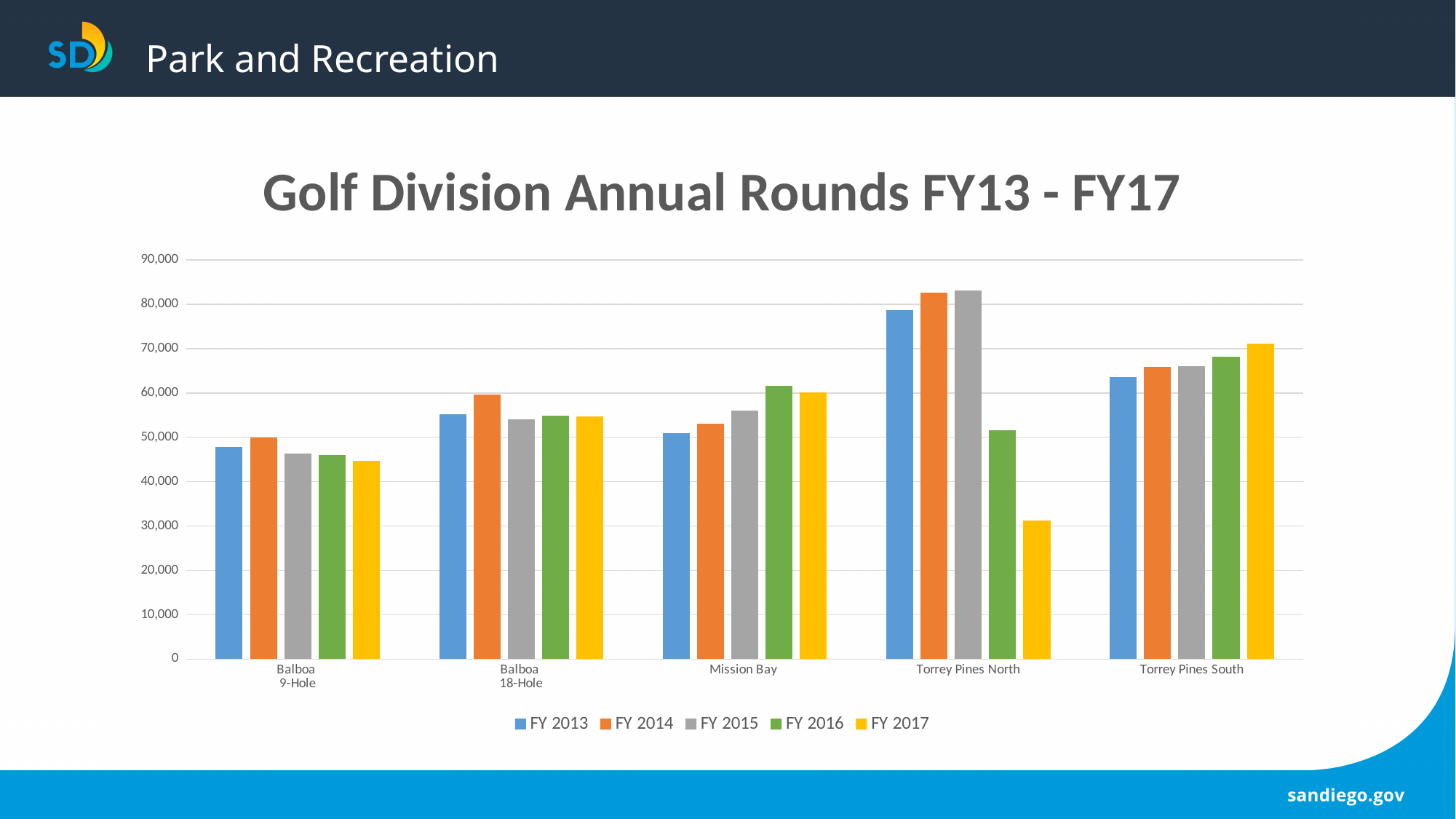
What is the title of the chart? Golf Division Annual Rounds FY13 - FY17 What kind of chart is shown on the slide? Bar chart How many golf course categories are shown on the x axis? 5 Which is larger for FY 2014: Balboa 9-Hole or Balboa 18-Hole? Balboa 18-Hole Is the FY 2017 value for Torrey Pines South greater or less than 70,000? greater Is the FY 2017 value for Torrey Pines North greater or less than 40,000? less Do the values for Torrey Pines South rise or fall from FY 2013 to FY 2017? rise How many series does the legend list? 5 Which fiscal year has the highest value for Balboa 18-Hole? FY 2014 Which golf course has the highest FY 2015 value? Torrey Pines North Is the FY 2016 value for Mission Bay greater or less than 60,000? greater Which golf course has the lowest FY 2017 value? Torrey Pines North